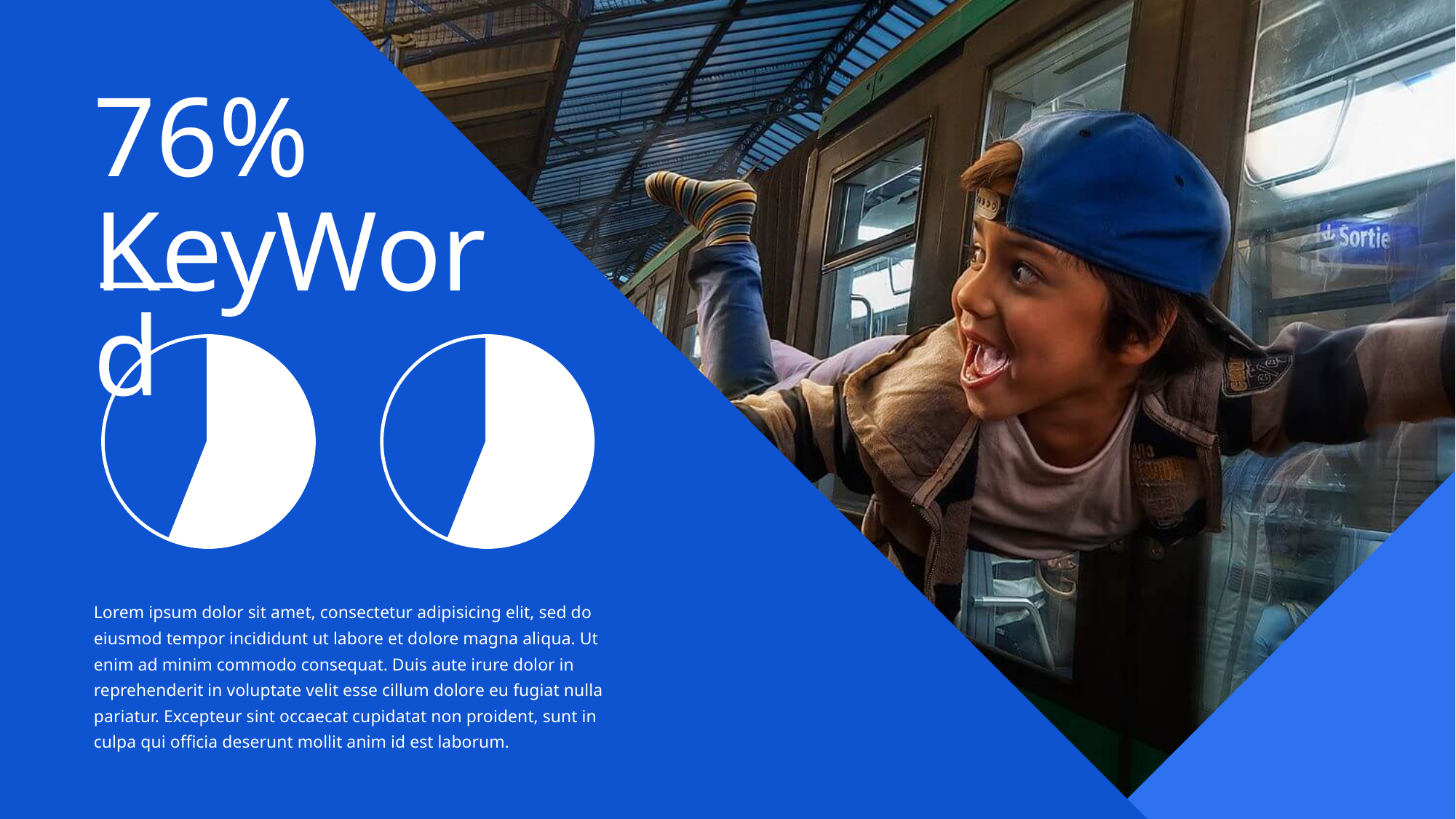
What kind of chart is the right chart on the slide? pie chart How many pie charts are shown on the slide? 2 Does either pie chart on the slide show a legend? No In the left pie chart, which slice is larger, the white slice or the blue slice? the white slice What two colours are used for the slices in the pie charts? white and blue In the right pie chart, how many slices are there? 2 What kind of chart is the left chart on the slide? pie chart In the left pie chart, how many slices are there? 2 In the right pie chart, which slice is larger, the white slice or the blue slice? the white slice